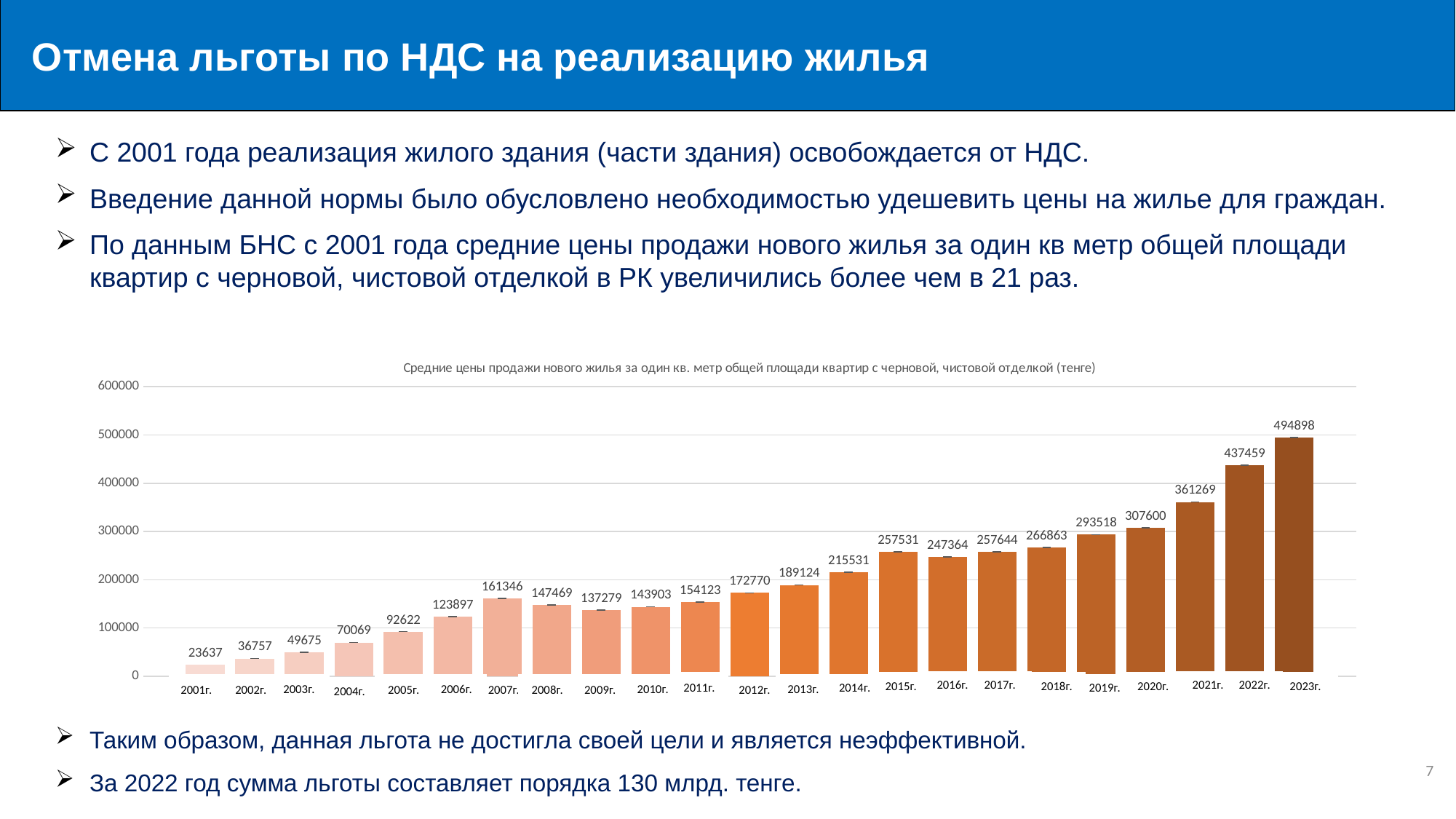
Which year has the lowest value on the chart? 2001г. How many years are shown on the x axis of the chart? 23 Which year has the highest value on the chart? 2023г. What value is shown for 2001г.? 23637 What kind of chart is shown on the slide? bar chart Do the values generally rise or fall from 2001г. to 2023г.? rise Is the value for 2021г. greater or less than 300000? greater What value is shown for 2012г.? 172770 What is the average sale price per square metre shown for 2023г.? 494898 Which is larger, the value for 2007г. or the value for 2008г.? 2007г. What is the difference between the values for 2007г. and 2008г.? 13877 What is the difference between the values for 2023г. and 2022г.? 57439